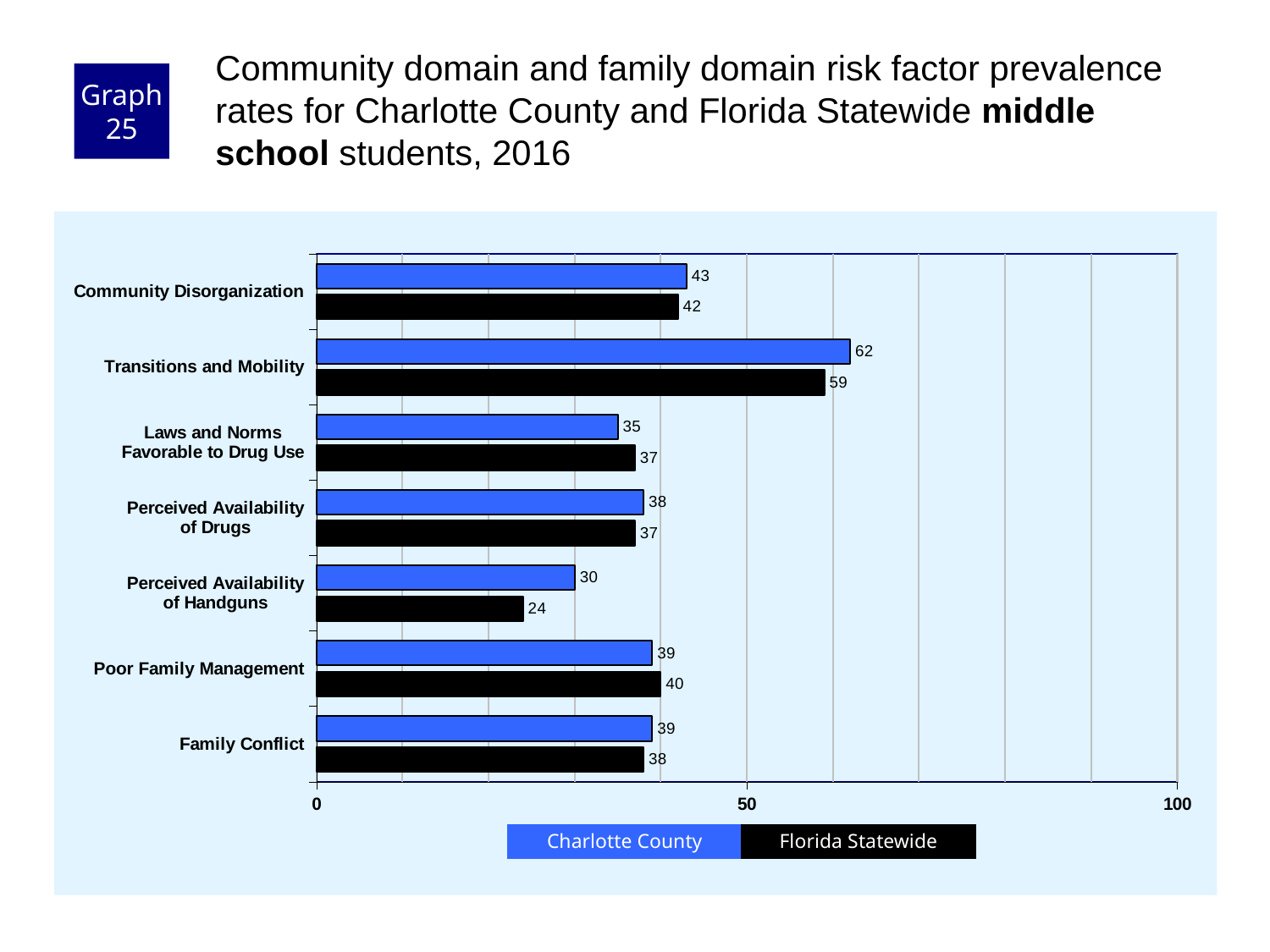
What is the Florida Statewide value for Perceived Availability of Handguns? 24 What kind of chart is shown on the slide? Bar chart What is the Charlotte County value for Transitions and Mobility? 62 Is the Florida Statewide value for Transitions and Mobility greater or less than 50? greater Which risk factor has the lowest Florida Statewide value? Perceived Availability of Handguns Which colour represents Florida Statewide in the chart? Black Which risk factor has the highest Charlotte County value? Transitions and Mobility How many series does the legend list? 2 For Laws and Norms Favorable to Drug Use, which is larger: the Charlotte County value or the Florida Statewide value? Florida Statewide What is the Florida Statewide value for Poor Family Management? 40 How many risk factor categories are shown on the chart? 7 What is the difference between the Charlotte County and Florida Statewide values for Perceived Availability of Handguns? 6